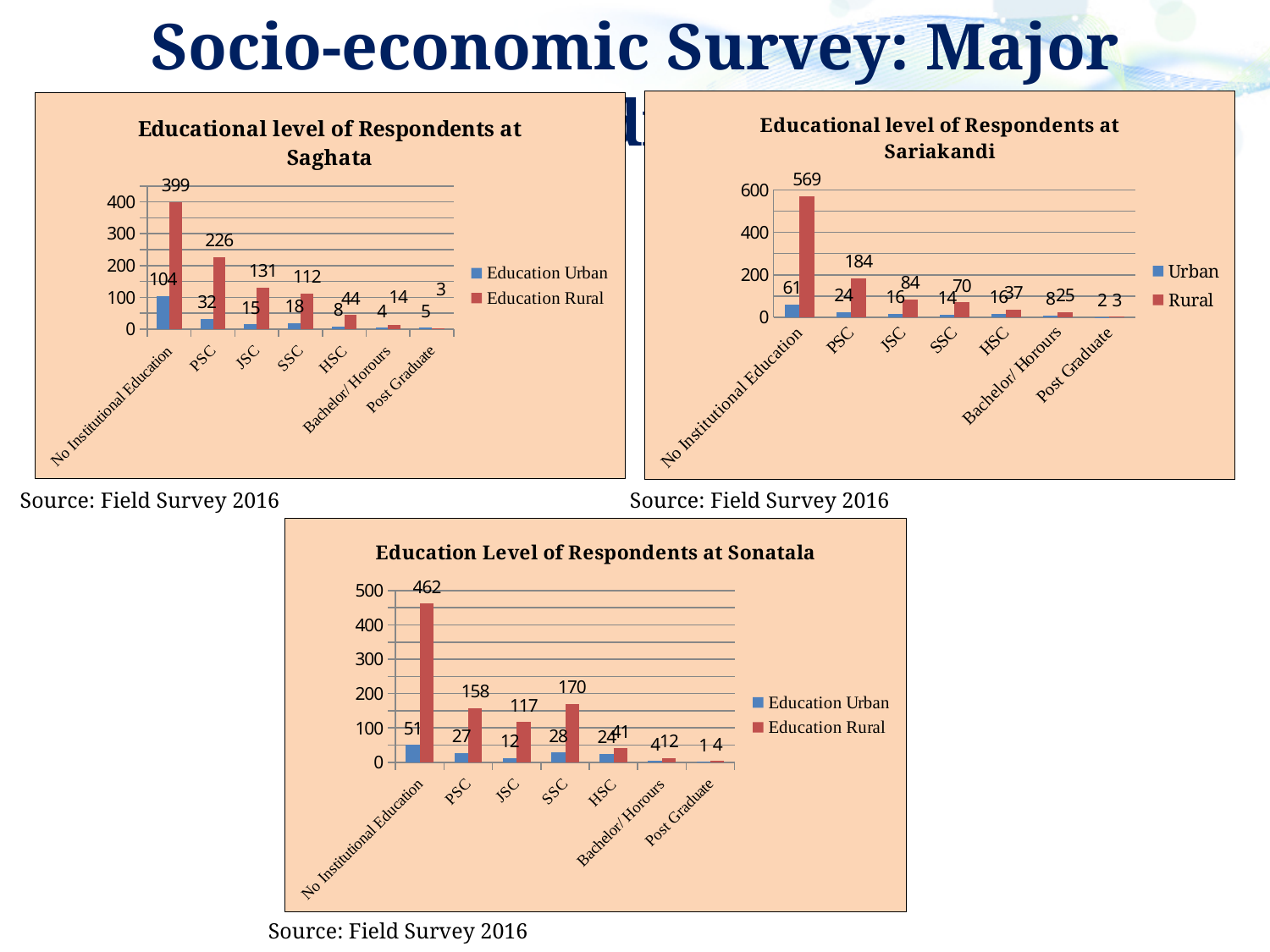
In the 'Educational level of Respondents at Sariakandi' chart, which category has the highest Rural value? No Institutional Education In the 'Educational level of Respondents at Sariakandi' chart, what is the Urban value for No Institutional Education? 61 In the 'Education Level of Respondents at Sonatala' chart, what is the Education Rural value for SSC? 170 In the 'Educational level of Respondents at Sariakandi' chart, what is the difference between the Rural values for JSC and SSC? 14 In the 'Educational level of Respondents at Saghata' chart, what is the difference between the Education Rural values for PSC and JSC? 95 In the 'Educational level of Respondents at Sariakandi' chart, what is the Rural value for No Institutional Education? 569 In the 'Education Level of Respondents at Sonatala' chart, which is larger, the Education Rural value for PSC or for SSC? SSC What kind of chart is the 'Education Level of Respondents at Sonatala' chart? bar chart In the 'Educational level of Respondents at Saghata' chart, do the Education Rural values rise or fall moving from left to right along the x axis? fall In the 'Educational level of Respondents at Saghata' chart, what is the Education Rural value for No Institutional Education? 399 How many education categories are shown on the x axis of the 'Education Level of Respondents at Sonatala' chart? 7 In the 'Educational level of Respondents at Saghata' chart, what is the Education Urban value for PSC? 32